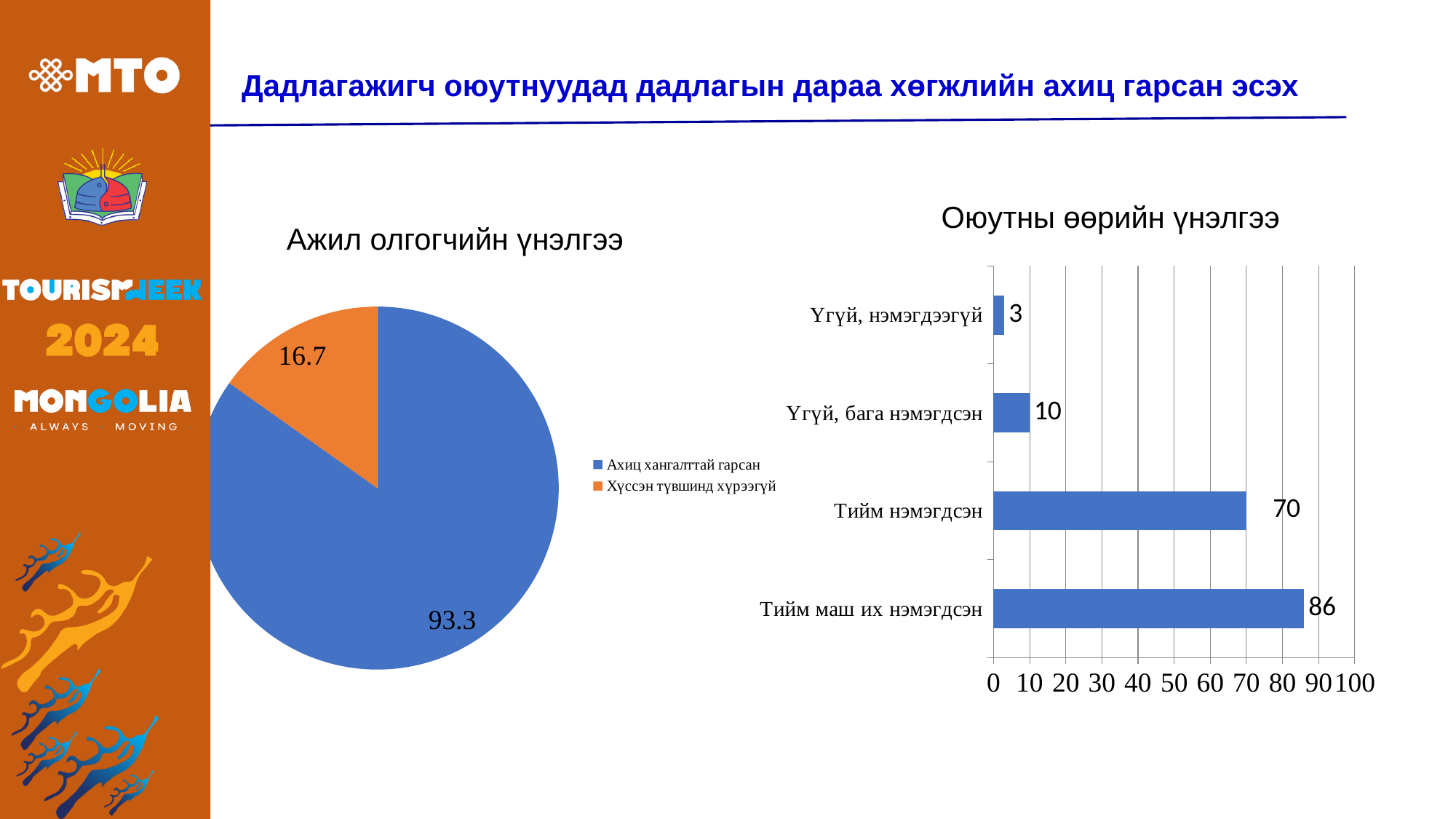
In the chart titled "Оюутны өөрийн үнэлгээ", what is the value for "Үгүй, бага нэмэгдсэн"? 10 In the chart titled "Оюутны өөрийн үнэлгээ", which category has the lowest value? Үгүй, нэмэгдээгүй How many entries does the legend of the chart "Ажил олгогчийн үнэлгээ" list? 2 In the chart titled "Оюутны өөрийн үнэлгээ", what is the difference between the values for "Тийм маш их нэмэгдсэн" and "Тийм нэмэгдсэн"? 16 In the chart titled "Ажил олгогчийн үнэлгээ", what value is shown for "Ахиц хангалттай гарсан"? 93.3 In the chart titled "Оюутны өөрийн үнэлгээ", what is the value for "Тийм маш их нэмэгдсэн"? 86 How many categories are shown in the chart titled "Оюутны өөрийн үнэлгээ"? 4 What kind of chart is "Ажил олгогчийн үнэлгээ"? Pie chart In the chart titled "Ажил олгогчийн үнэлгээ", what value is shown for "Хүссэн түвшинд хүрээгүй"? 16.7 In the chart titled "Оюутны өөрийн үнэлгээ", which category has the highest value? Тийм маш их нэмэгдсэн In the chart titled "Ажил олгогчийн үнэлгээ", which slice is larger, "Ахиц хангалттай гарсан" or "Хүссэн түвшинд хүрээгүй"? Ахиц хангалттай гарсан What kind of chart is "Оюутны өөрийн үнэлгээ"? Bar chart